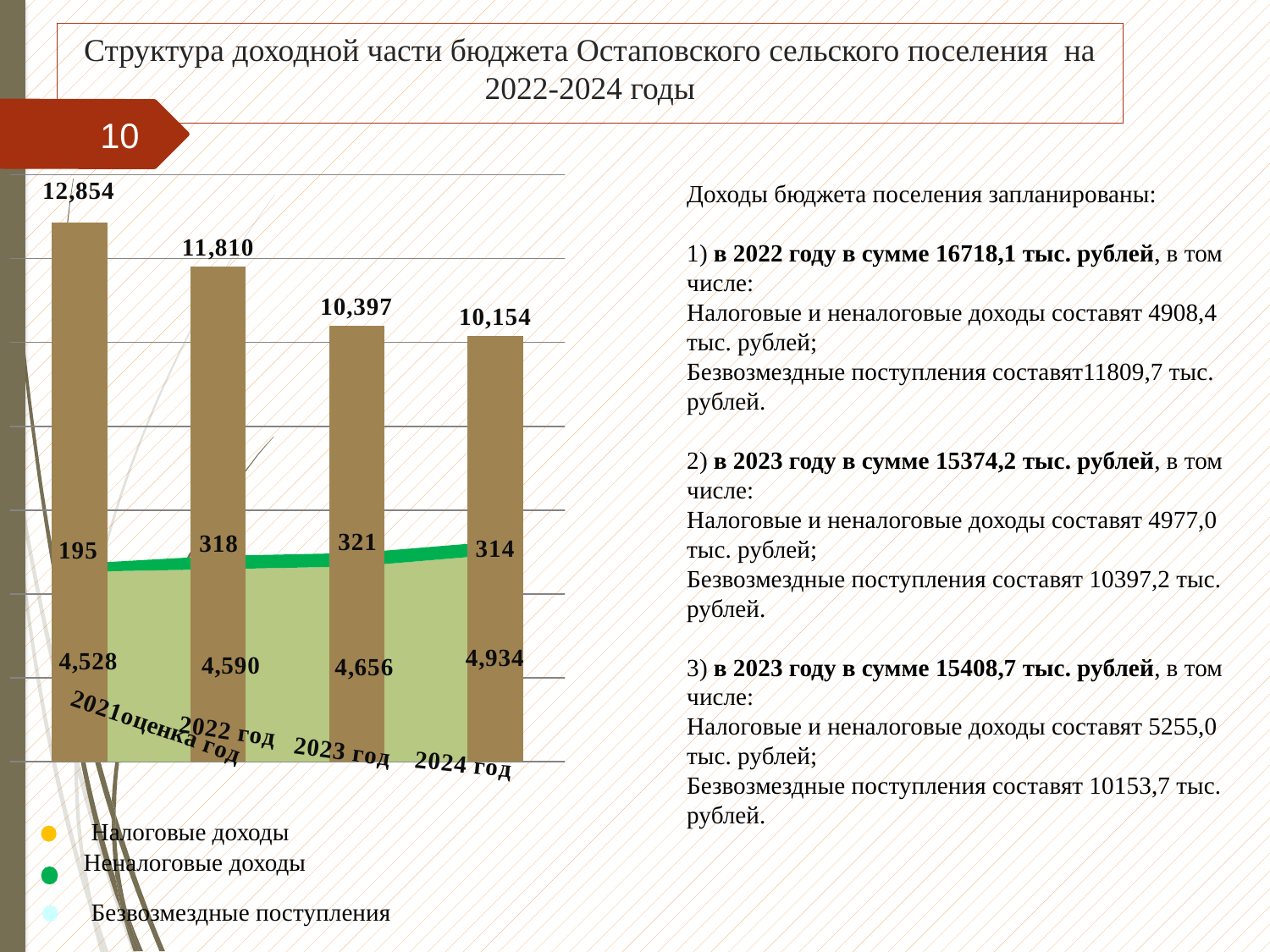
Which year has the lowest bar value? 2024 год In which year is the Неналоговые доходы value highest? 2023 год Do the bar values rise or fall from 2021оценка год to 2024 год? fall What is the value labelled for Неналоговые доходы in 2023 год? 321 What is the difference between the Налоговые доходы values for 2024 год and 2021оценка год? 406 How many year categories are shown on the x axis? 4 What is the difference between the bar values for 2021оценка год and 2024 год? 2,700 How many series does the legend list? 3 What is the value of the bar for 2022 год? 11,810 What is the value labelled for Налоговые доходы in 2024 год? 4,934 Which is larger, the Налоговые доходы value for 2021оценка год or for 2024 год? 2024 год Which year has the highest bar value? 2021оценка год